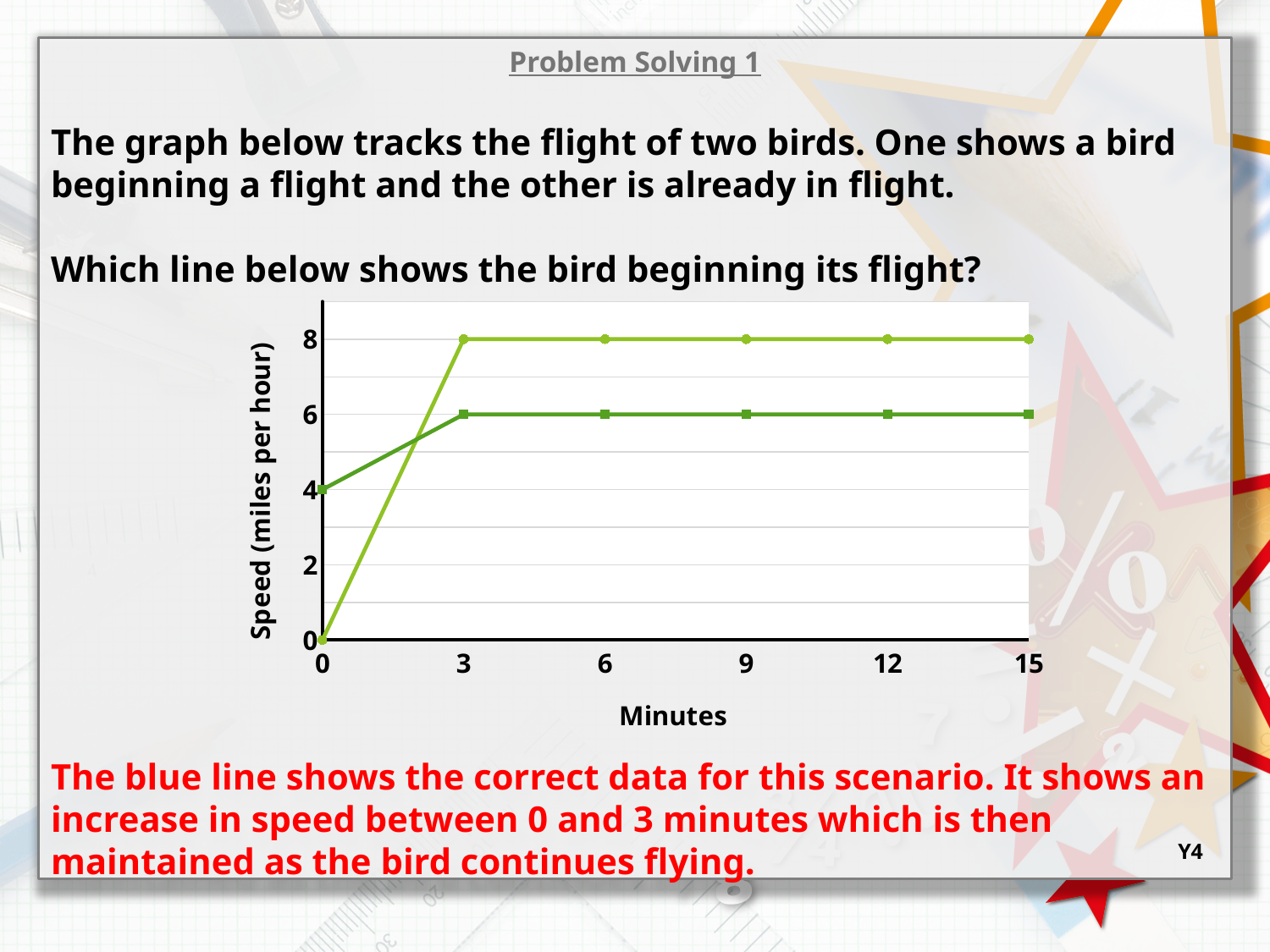
At 0 minutes, which line shows the higher speed, the one with circle markers or the one with square markers? the line with square markers What is the label on the vertical axis of the chart? Speed (miles per hour) What is the speed of the line with square markers at 0 minutes? 4 What is the speed of the line with square markers at 6 minutes? 6 How many lines are plotted on the chart? 2 At 15 minutes, what is the difference in speed between the line with circle markers and the line with square markers? 2 What is the speed of the line with circle markers at 0 minutes? 0 What is the speed of the line with circle markers at 3 minutes? 8 How many data points are plotted on each line? 6 What is the highest speed reached by either line on the chart? 8 What kind of chart is shown on the slide? line chart Does the line with circle markers rise or fall between 0 and 3 minutes? rise